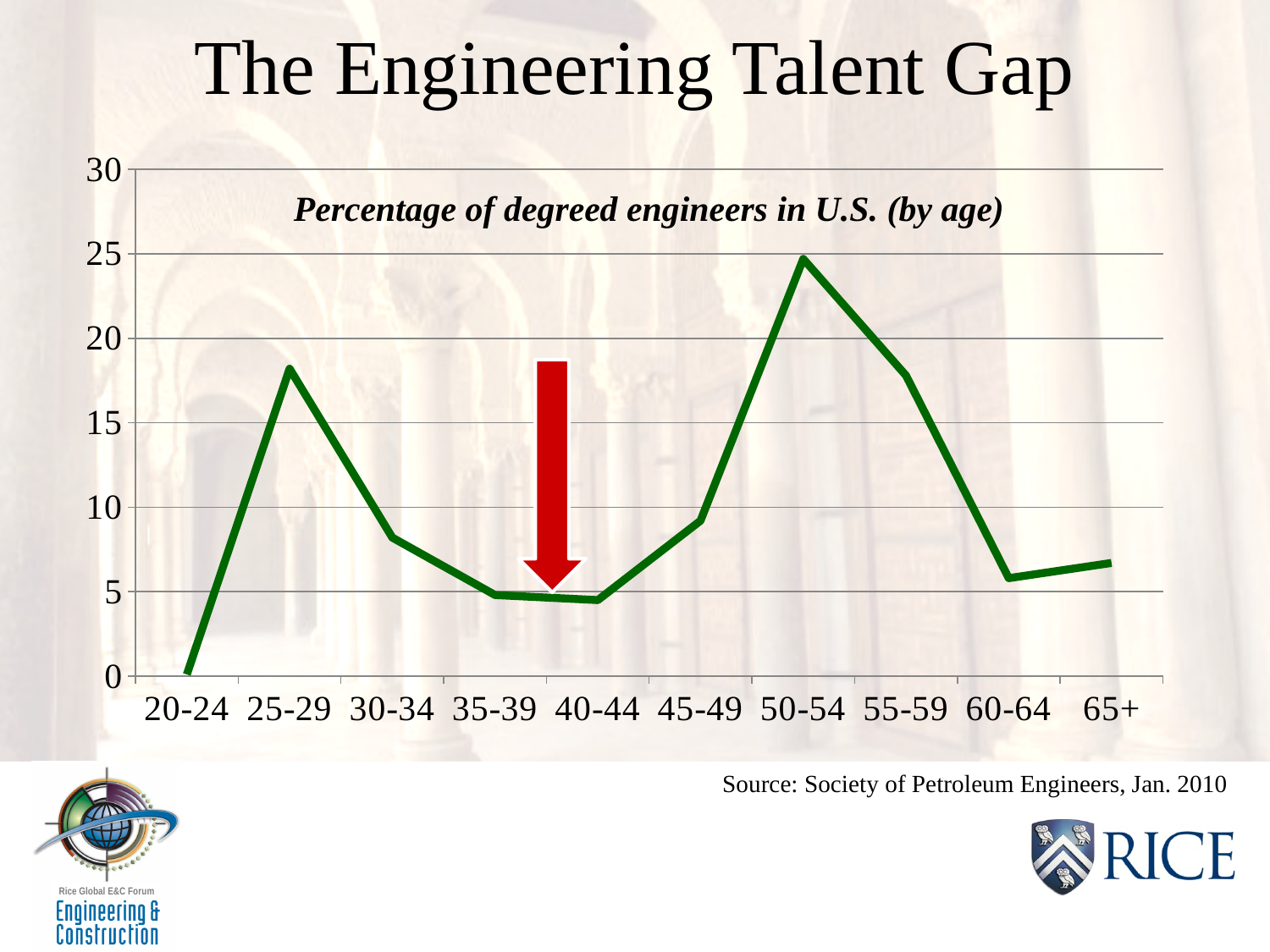
Is the value for the 25-29 age group greater or less than 15? greater Is the value for the 40-44 age group greater or less than 5? less How many age groups are plotted along the x axis? 10 Which age group has the lowest percentage of degreed engineers? 20-24 Which age group has a higher value, 50-54 or 30-34? 50-54 What kind of chart is shown on the slide? line chart What does the text inside the chart say the line represents? Percentage of degreed engineers in U.S. (by age) Is the value for the 60-64 age group greater or less than 10? less Do the values rise or fall from the 50-54 age group to the 60-64 age group? fall Which age group has the highest percentage of degreed engineers? 50-54